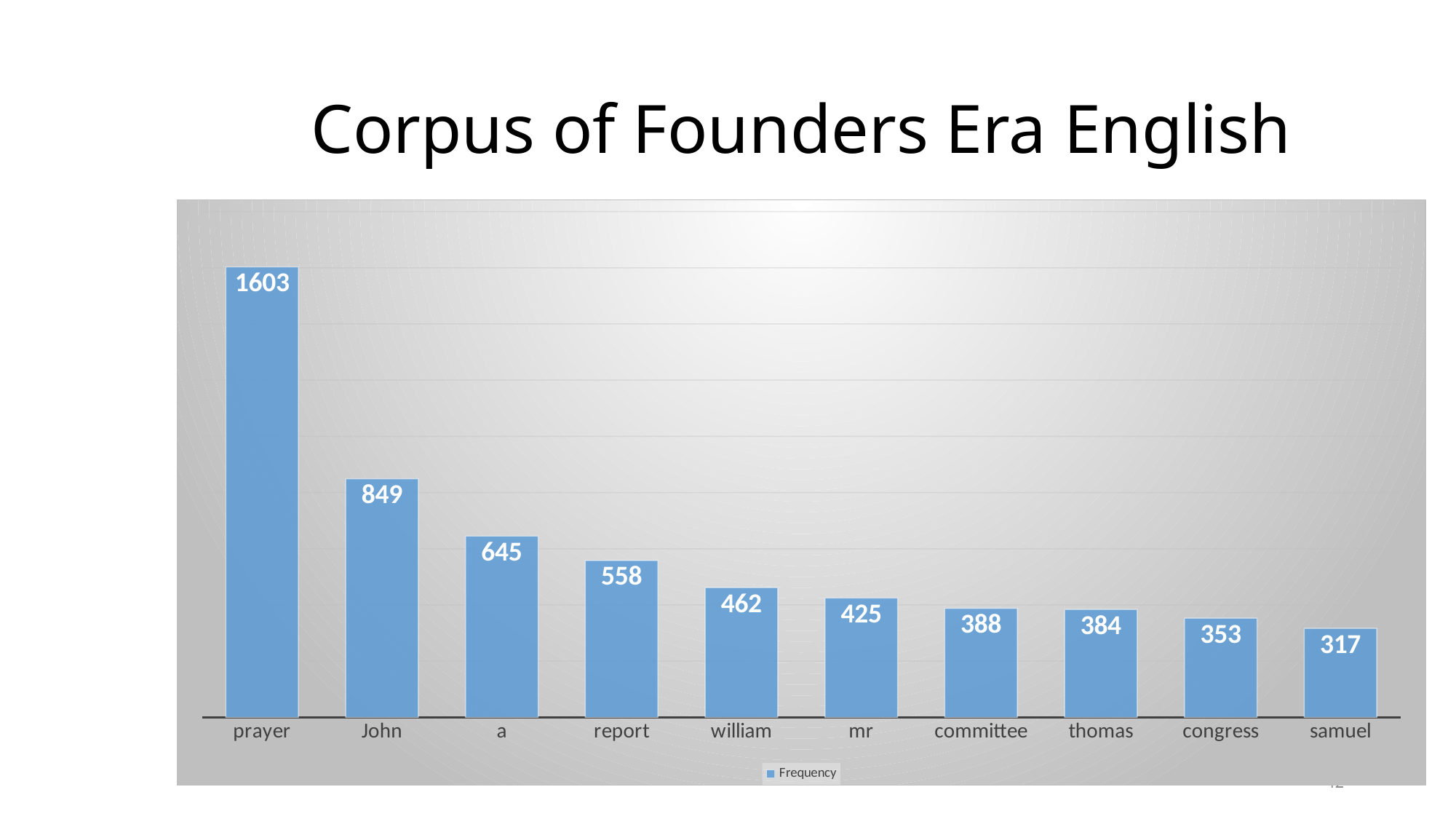
Do the frequency values rise or fall from left to right along the x axis? fall What is the frequency value for "samuel"? 317 How many categories are shown on the x axis? 10 Which category has the highest frequency? prayer What is the frequency value for "committee"? 388 What is the difference between the frequency for "prayer" and the frequency for "John"? 754 Which has a higher frequency, "william" or "congress"? william Which category has the lowest frequency? samuel What is the frequency value for "prayer"? 1603 What is the difference between the frequency for "a" and the frequency for "report"? 87 What kind of chart is shown on the slide? bar chart How many series does the legend list? 1